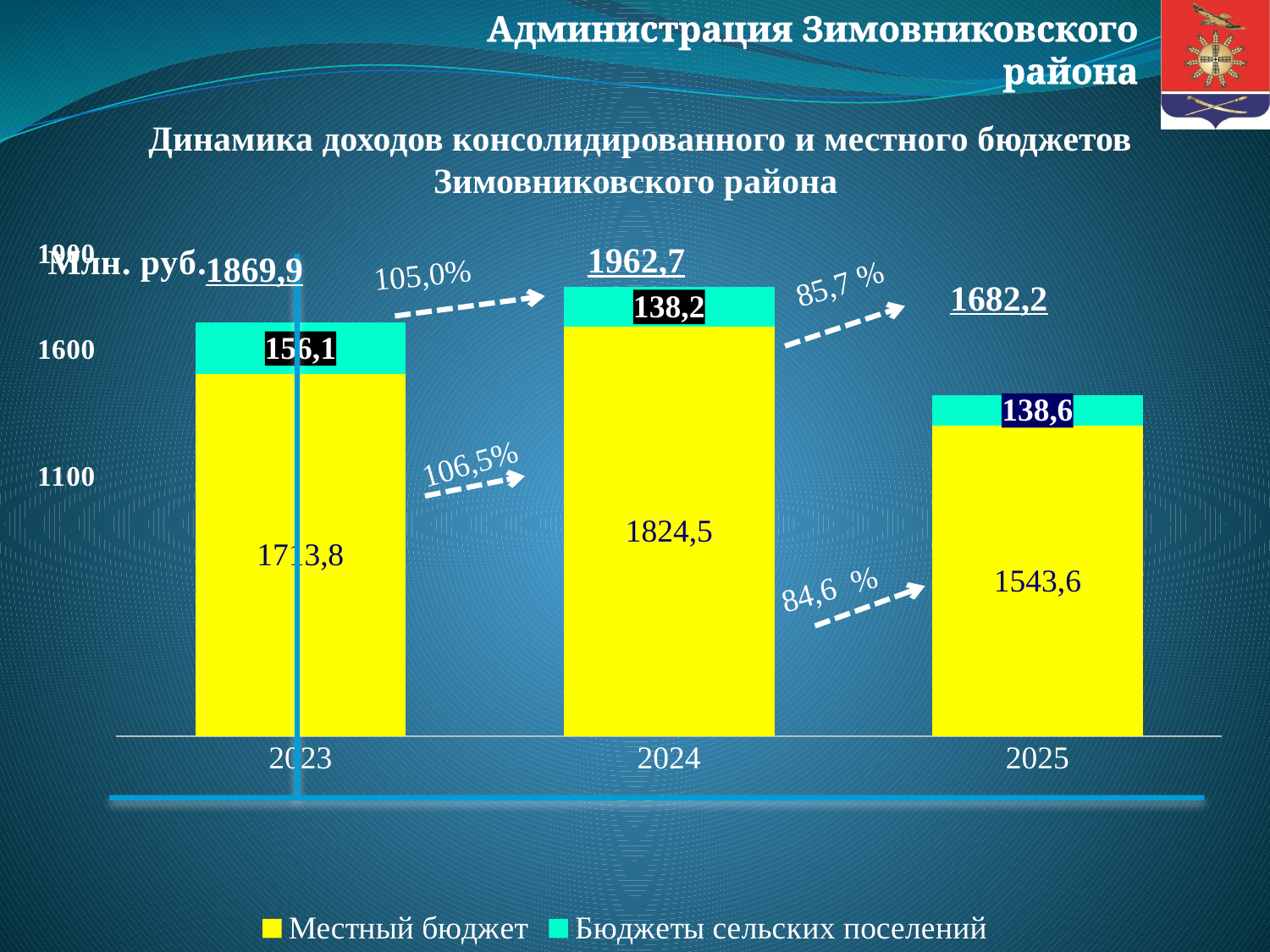
What is the value of Местный бюджет for 2025? 1543,6 How many series does the legend list? 2 How many years are shown on the x axis? 3 What is the value of Бюджеты сельских поселений for 2023? 156,1 What is the value of Местный бюджет for 2024? 1824,5 What is the difference between the Местный бюджет values for 2024 and 2025? 280,9 Which year has the lowest value for Местный бюджет? 2025 What is the total of the stacked bar for 2025? 1682,2 What is the value of Бюджеты сельских поселений for 2024? 138,2 What is the total of the stacked bar for 2024? 1962,7 Which year has the highest total consolidated budget revenue? 2024 What type of chart is shown on the slide? stacked bar chart